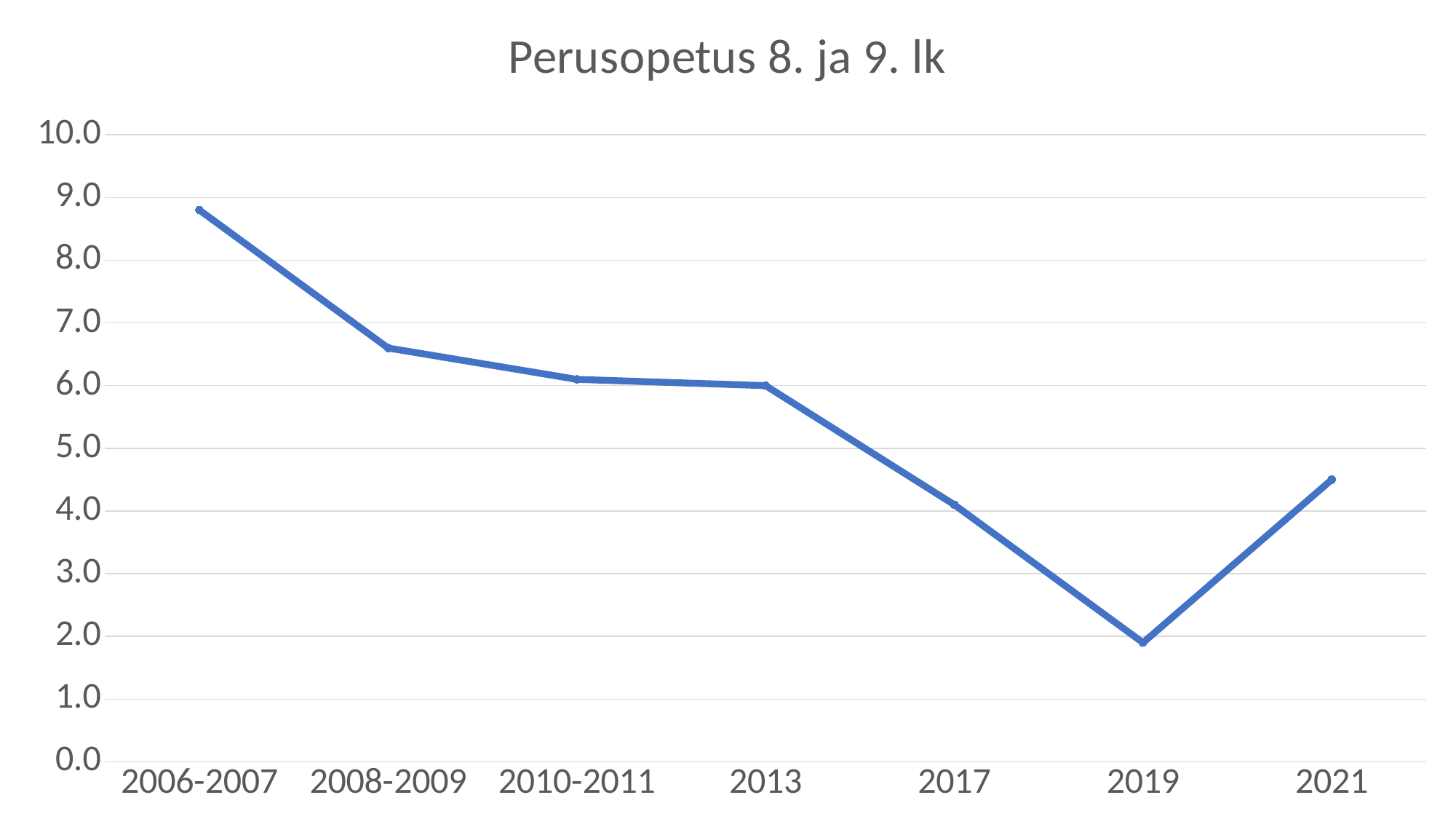
Is the value for 2021 greater or less than 4.0? greater What kind of chart is shown on the slide? line chart Is the value for 2019 greater or less than 3.0? less Which is larger, the value for 2019 or the value for 2021? 2021 What is the title of the chart? Perusopetus 8. ja 9. lk Which category has the highest value? 2006-2007 Do the values rise or fall from 2006-2007 to 2019? fall Which is larger, the value for 2008-2009 or the value for 2017? 2008-2009 Is the value for 2006-2007 greater or less than 8.0? greater Which category has the lowest value? 2019 How many data points are plotted on the line? 7